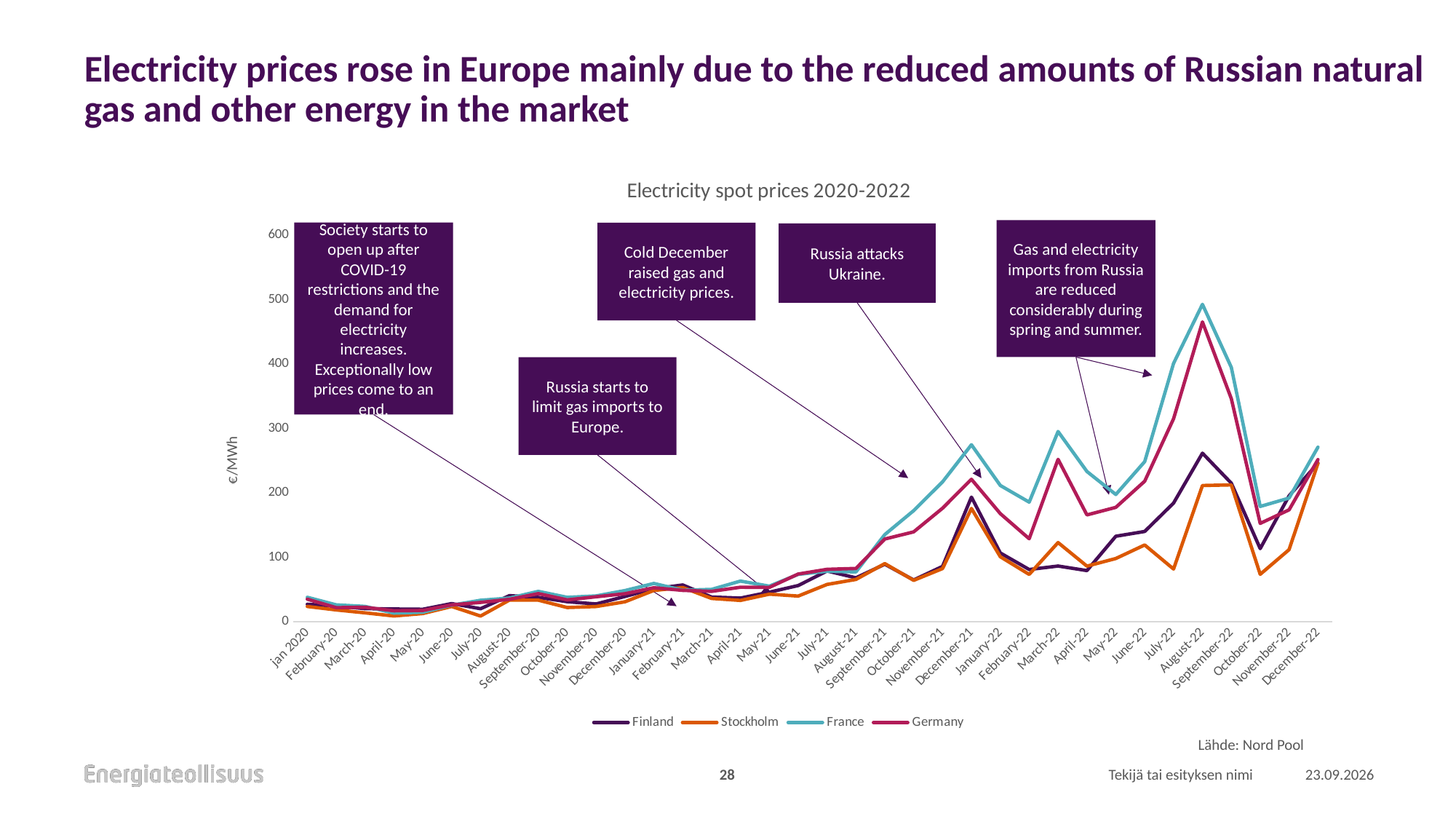
In March-22, which is larger: the value for France or the value for Finland? France What is the title of the chart? Electricity spot prices 2020-2022 How many series does the legend list? 4 Do the values for France generally rise or fall from January-21 to December-21? rise Is the value for Finland in August-22 greater or less than 300? less What kind of chart is shown on the slide? Line chart Is the value for Stockholm in October-22 greater or less than 100? less Is the value for France in August-22 greater or less than 400? greater What unit is shown on the y axis of the chart? €/MWh Which series reaches the highest value in August-22? France Which series has the lowest value in August-22? Stockholm How many months are plotted along the x axis? 36